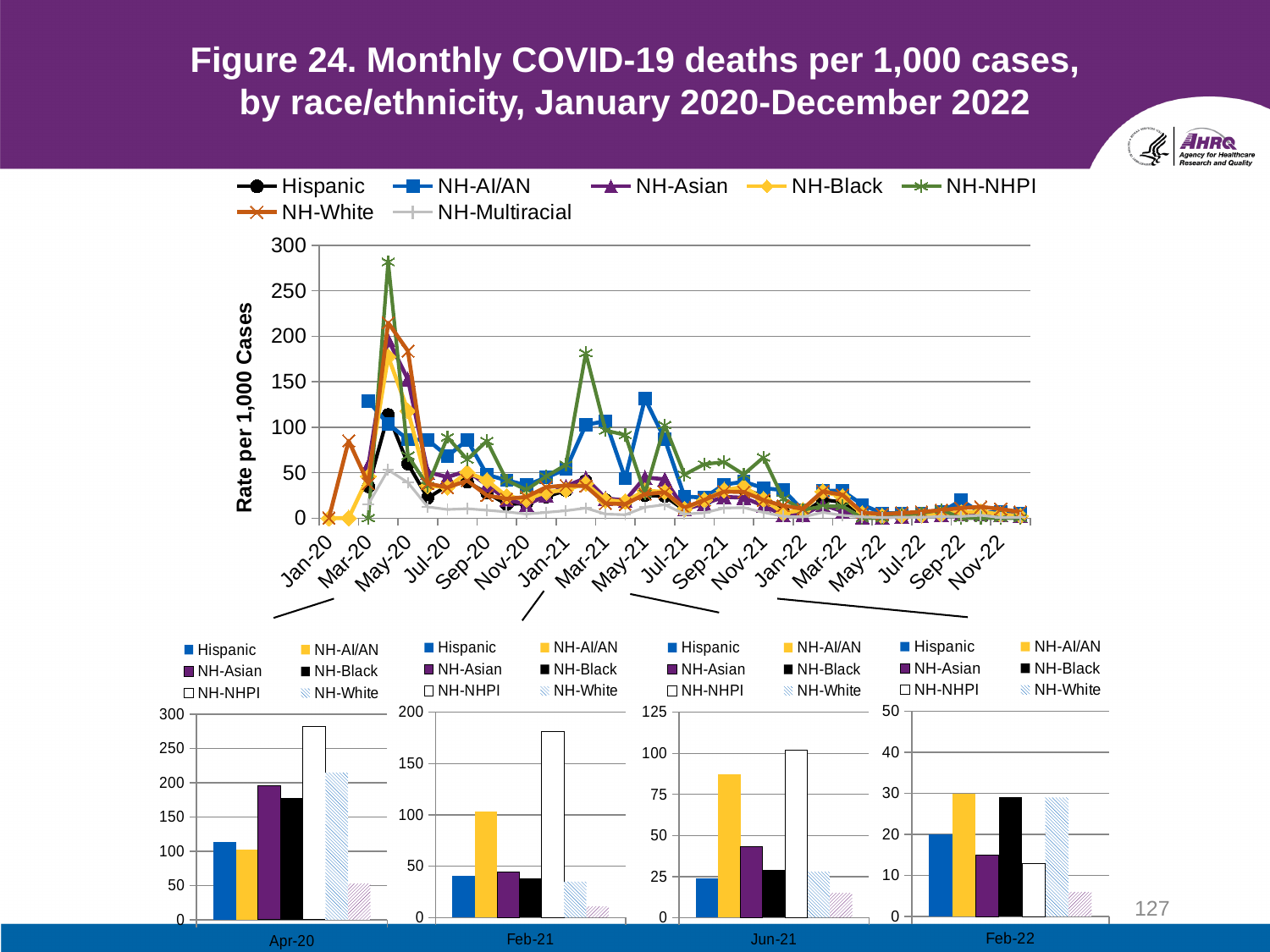
In the top line chart, is the peak value for NH-NHPI around Apr-20 greater or less than 250? greater How many series does the legend of the top line chart list? 7 In the Apr-20 bar chart, which group has the highest value? NH-NHPI How many series does the legend of the Apr-20 bar chart list? 6 In the Jun-21 bar chart, is the value for NH-AI/AN greater or less than 75? greater What kind of chart is the Apr-20 chart at the bottom left of the slide? bar chart In the Apr-20 bar chart, is the value for NH-Asian greater or less than 150? greater In the Feb-21 bar chart, which group has the highest value? NH-NHPI What kind of chart is the large chart at the top of the slide? line chart What is the y-axis label of the top line chart? Rate per 1,000 Cases In the top line chart, which series reaches the highest value over the whole period? NH-NHPI